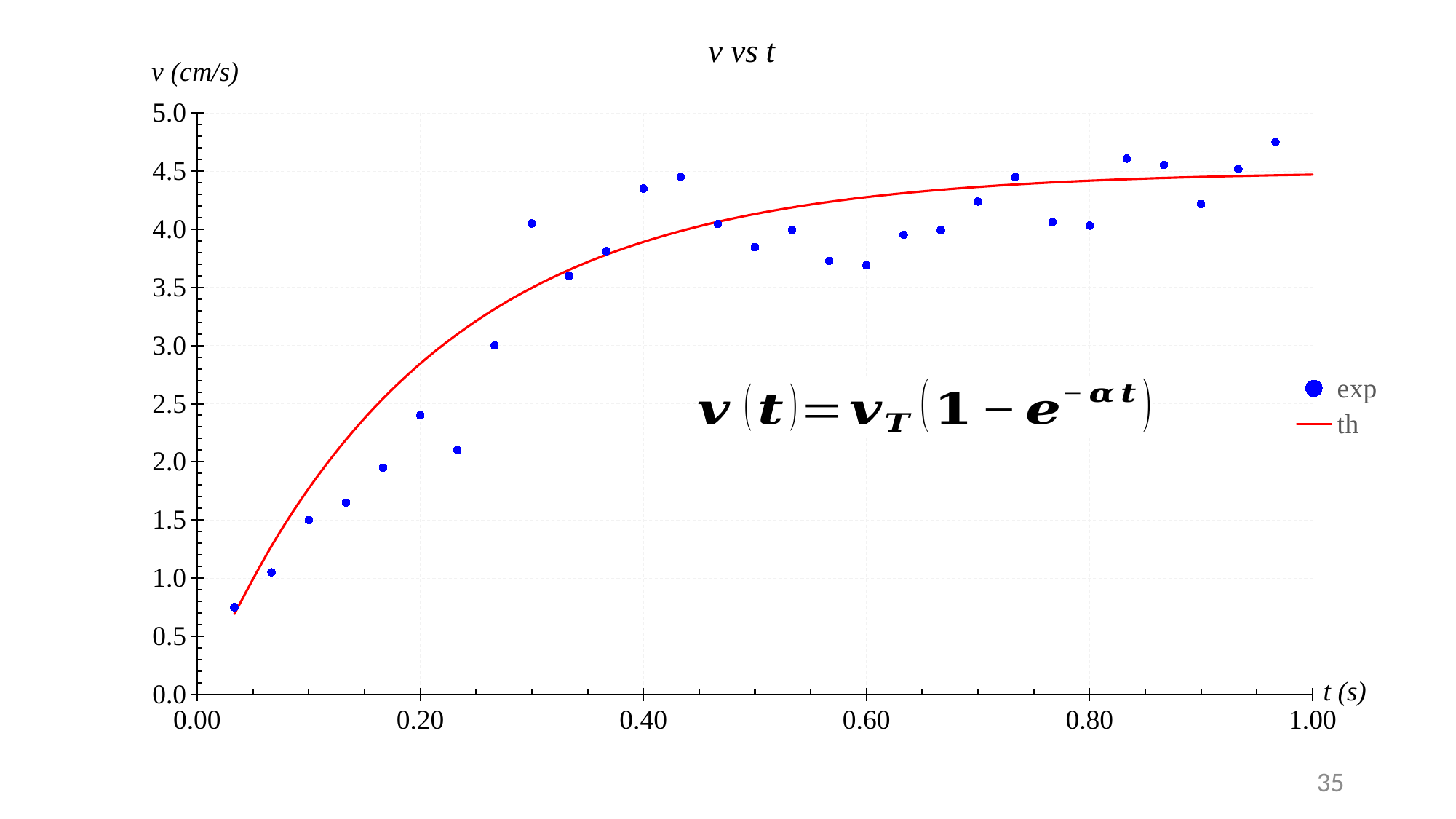
What is the title of the chart? v vs t How many exp data points are plotted? 29 Which is larger: the exp value at t ≈ 0.27 s or at t = 0.30 s? t = 0.30 s What are the two entries in the chart's legend? exp and th Do the experimental (exp) values generally rise or fall as t increases? rise What kind of chart is shown on the slide? scatter plot Is the exp value at t = 0.20 s greater or less than 2.0 cm/s? greater Which exp data point has the lowest v value? the first point, at t ≈ 0.03 s How many series does the legend list? 2 Is the exp value at the first data point (t ≈ 0.03 s) greater or less than 1.0 cm/s? less Is the exp value at the last data point (t ≈ 0.97 s) greater or less than 4.5 cm/s? greater